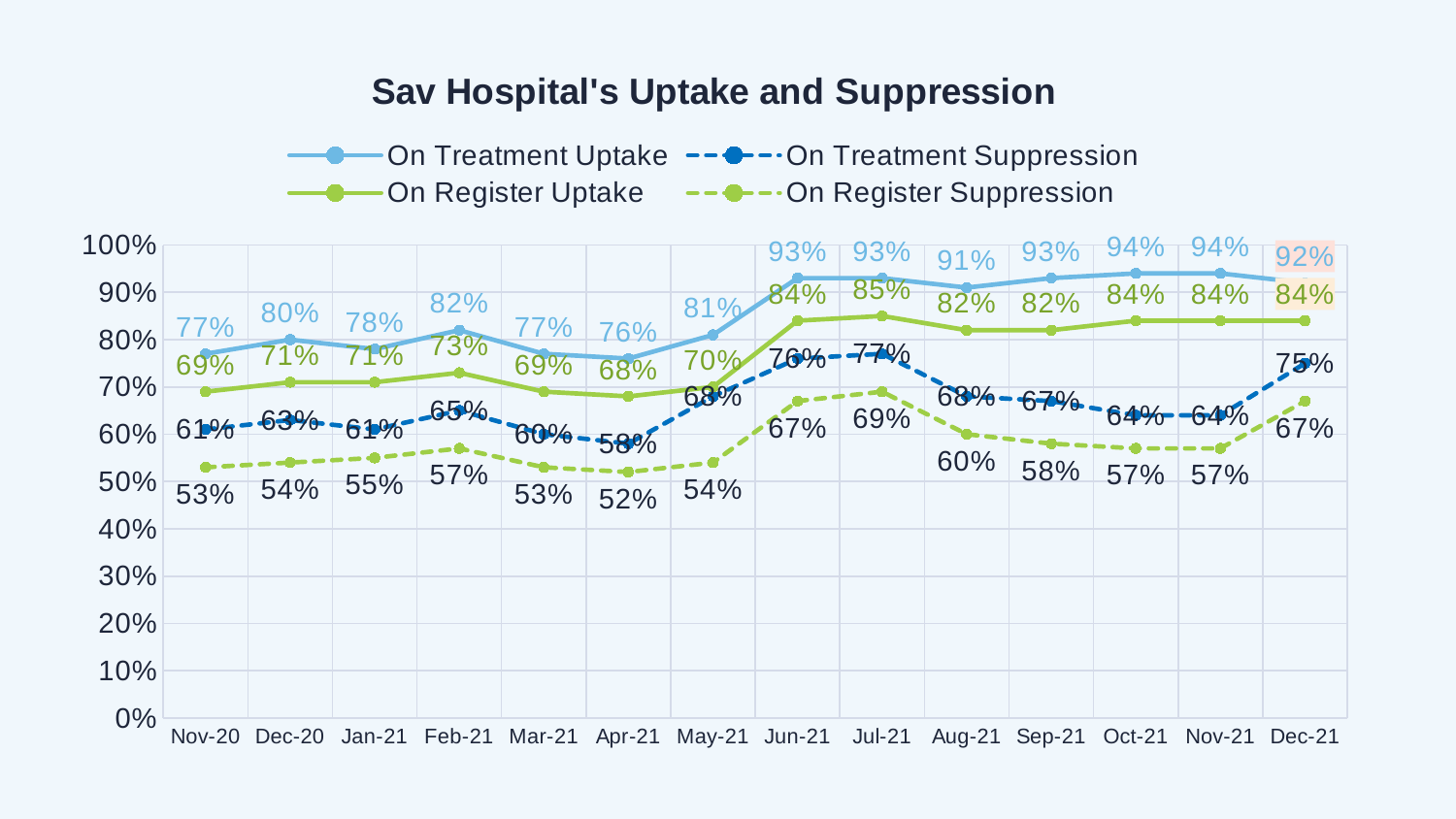
In which month is On Register Uptake at its highest? Jul-21 What kind of chart is shown on the slide? Line chart What is the On Treatment Uptake value for Jul-21? 93% How many months are plotted along the x axis? 14 Which month has the higher On Register Uptake, Jul-21 or Aug-21? Jul-21 How many series does the legend list? 4 Does On Treatment Uptake rise or fall from Apr-21 to Jun-21? Rise In which month is On Register Suppression at its lowest? Apr-21 What is the On Register Suppression value for Apr-21? 52% Is the On Treatment Suppression value for Dec-21 greater or less than 70%? greater What is the difference between On Treatment Uptake and On Register Uptake in Jun-21? 9 percentage points What is the On Register Uptake value for Dec-21? 84%